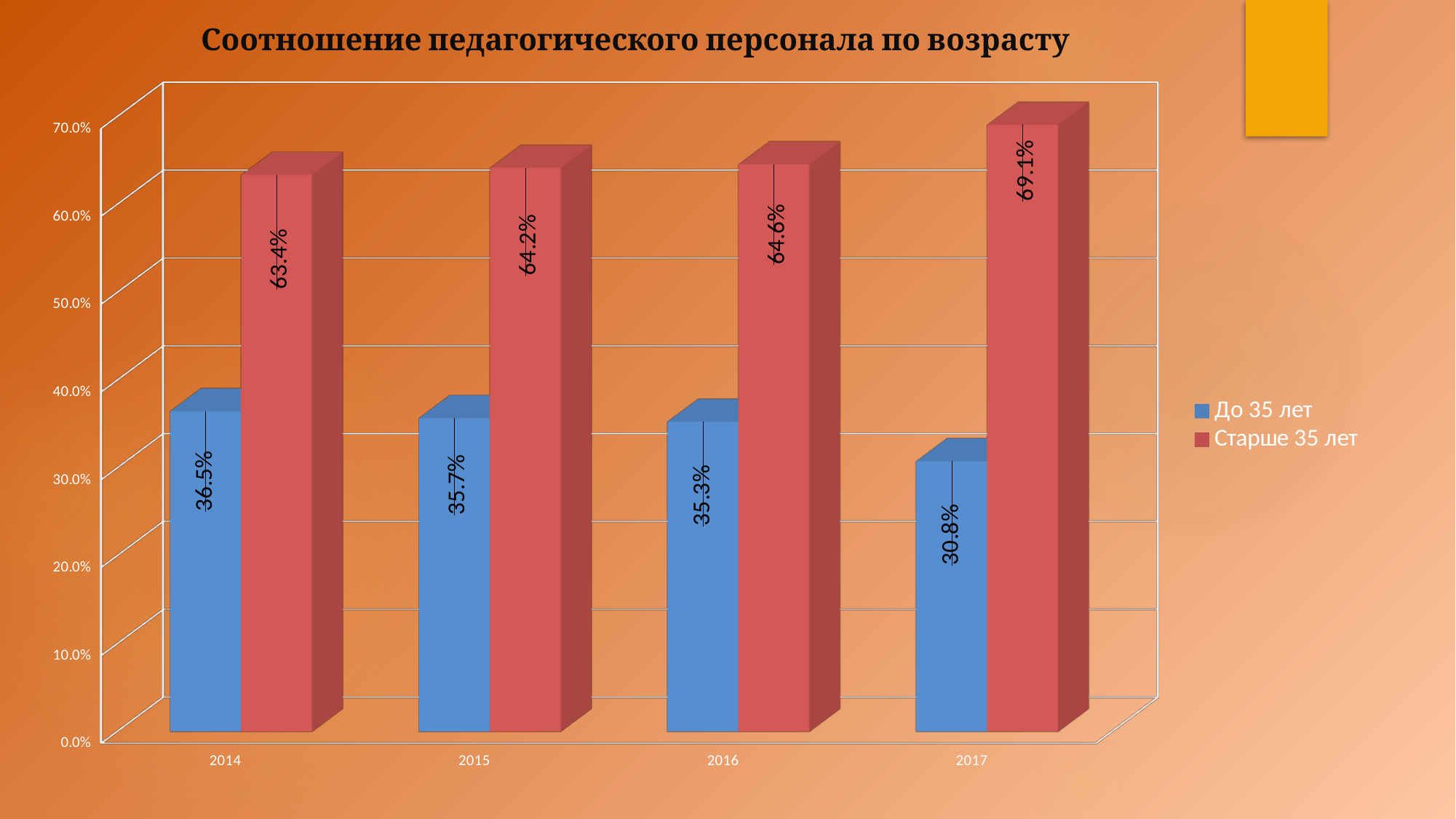
How many years are shown on the x axis? 4 What is the value for "Старше 35 лет" in 2015? 64.2% How many series does the legend list? 2 What is the value for "До 35 лет" in 2014? 36.5% Is the value for "До 35 лет" in 2017 greater or less than 40%? less Does the value for "До 35 лет" rise or fall from 2014 to 2017? fall What is the value for "Старше 35 лет" in 2017? 69.1% Which is larger in 2015: "До 35 лет" or "Старше 35 лет"? Старше 35 лет In which year is the value for "Старше 35 лет" highest? 2017 What kind of chart is shown on the slide? bar chart What is the difference between the "Старше 35 лет" and "До 35 лет" values in 2016? 29.3% In which year is the value for "До 35 лет" lowest? 2017